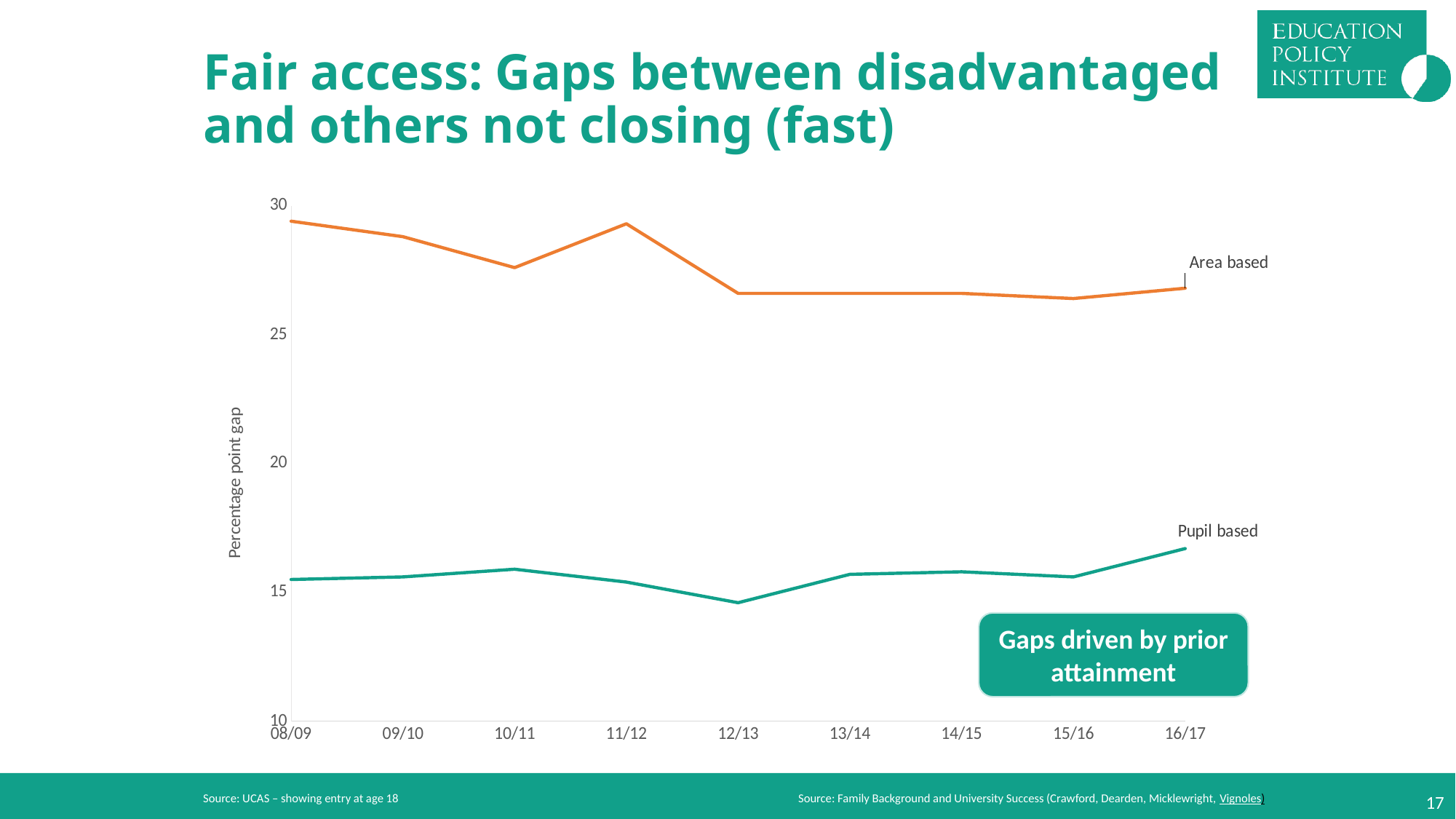
What kind of chart is shown on the slide? Line chart In which year is the Pupil based gap highest? 16/17 Is the Area based value for 15/16 greater or less than 30? less Does the Area based gap rise or fall overall from 08/09 to 16/17? Fall What is the label on the vertical axis of the chart? Percentage point gap Is the Area based value for 08/09 greater or less than 25? greater Is the Pupil based value for 12/13 greater or less than 15? less How many series are plotted on the chart? 2 In which year is the Pupil based gap lowest? 12/13 Which series has the larger value in 16/17, Area based or Pupil based? Area based How many academic years are shown along the x axis? 9